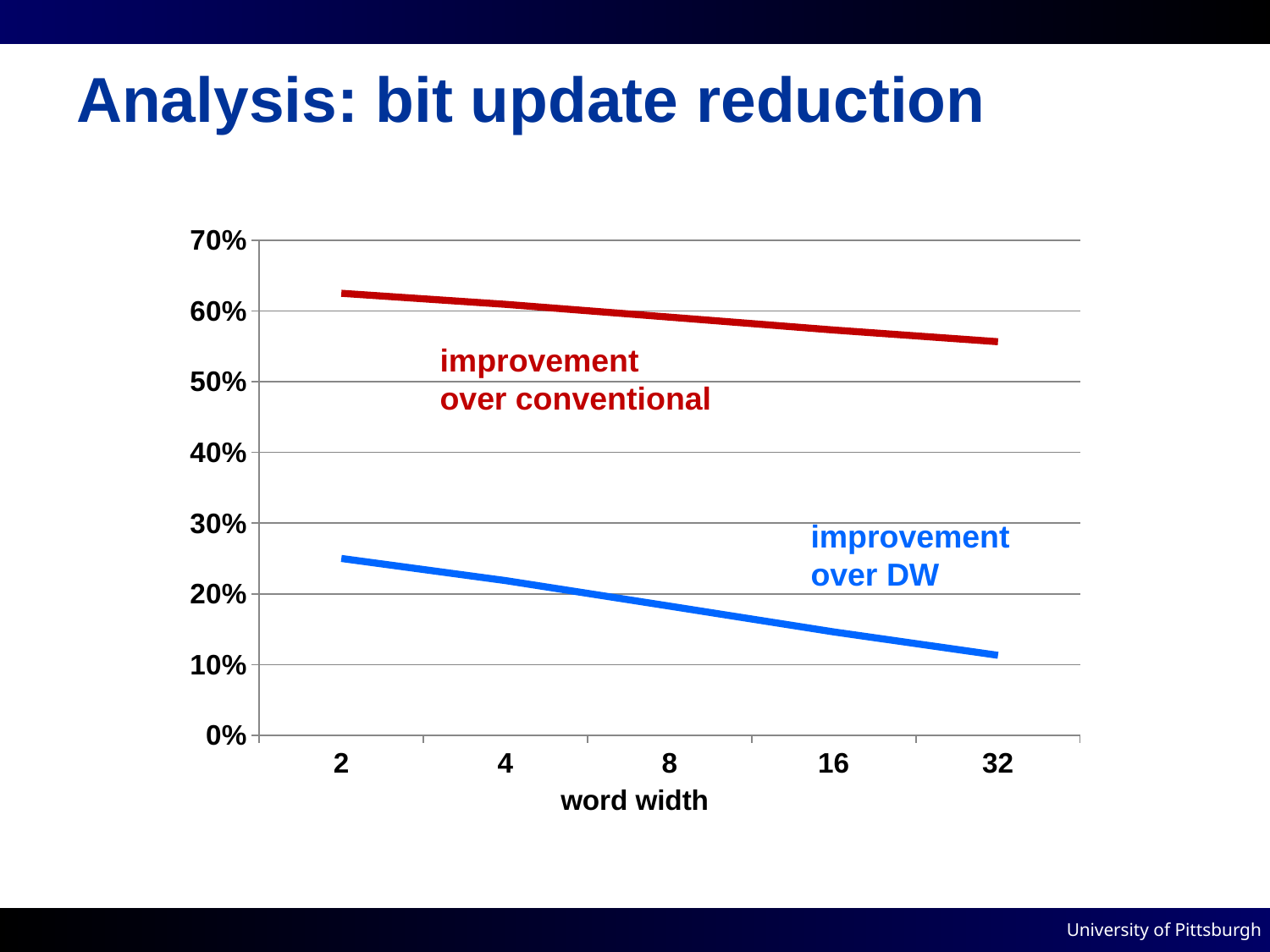
Is the 'improvement over conventional' value at word width 32 greater or less than 60%? less At word width 8, which series has the larger value: 'improvement over conventional' or 'improvement over DW'? improvement over conventional Does the 'improvement over conventional' line rise or fall as word width increases? fall What is the label of the x axis? word width Is the 'improvement over DW' value at word width 2 greater or less than 20%? greater Does the 'improvement over DW' line rise or fall as word width increases? fall Is the 'improvement over DW' value at word width 16 greater or less than 20%? less What kind of chart is shown on the slide? line chart How many word width values are shown on the x axis? 5 How many data series are plotted on the chart? 2